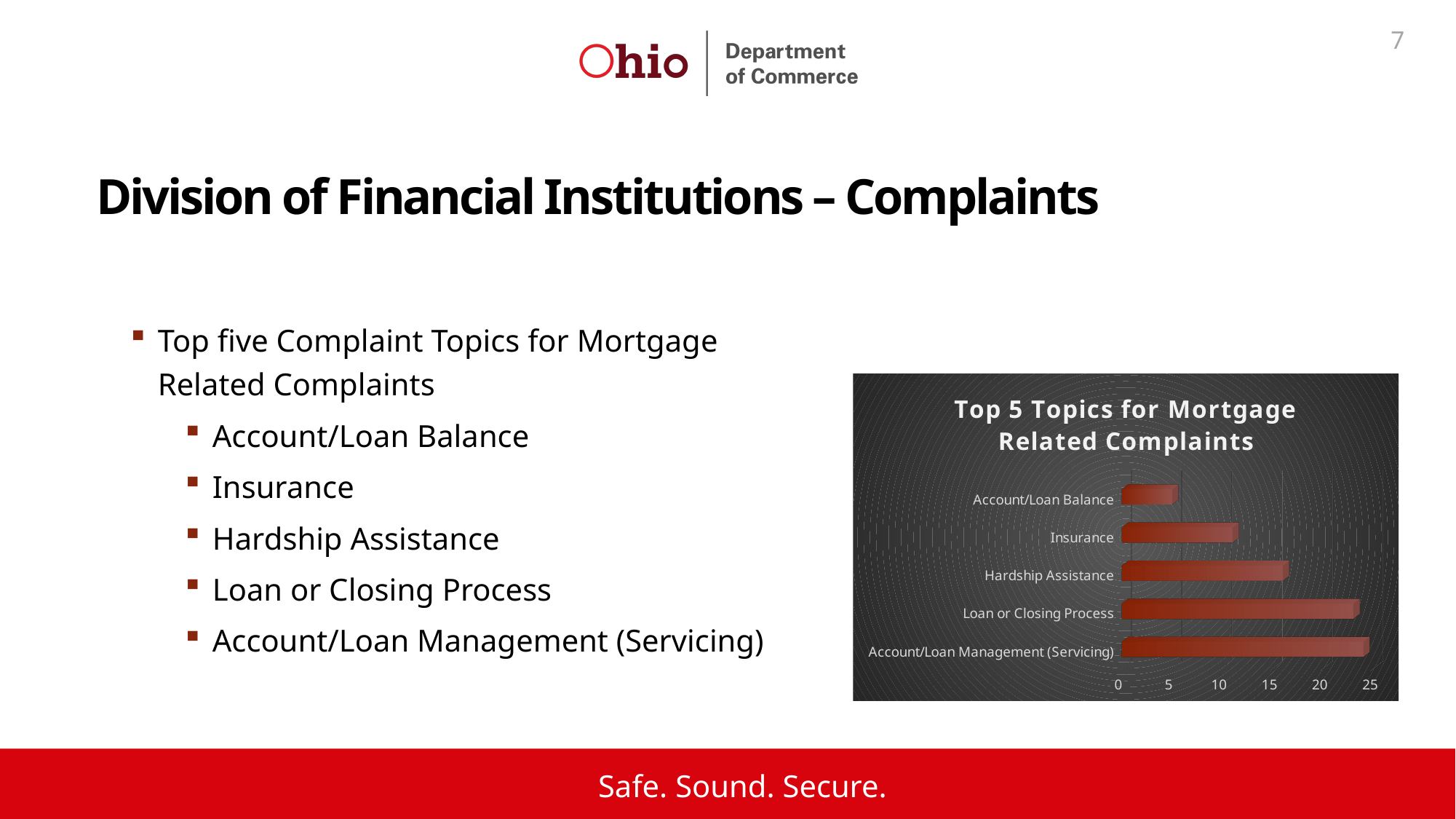
Is the value for Insurance greater or less than 10? greater Is the value for Hardship Assistance greater or less than 15? greater Which has the larger value, Loan or Closing Process or Account/Loan Balance? Loan or Closing Process What is the title of the chart on the slide? Top 5 Topics for Mortgage Related Complaints What is the highest tick value shown on the chart's horizontal axis? 25 Is the value for Loan or Closing Process greater or less than 20? greater How many complaint topics are plotted in the chart? 5 What kind of chart is shown on the slide? bar chart Which complaint topic has the lowest value in the chart? Account/Loan Balance Which has the larger value, Hardship Assistance or Insurance? Hardship Assistance